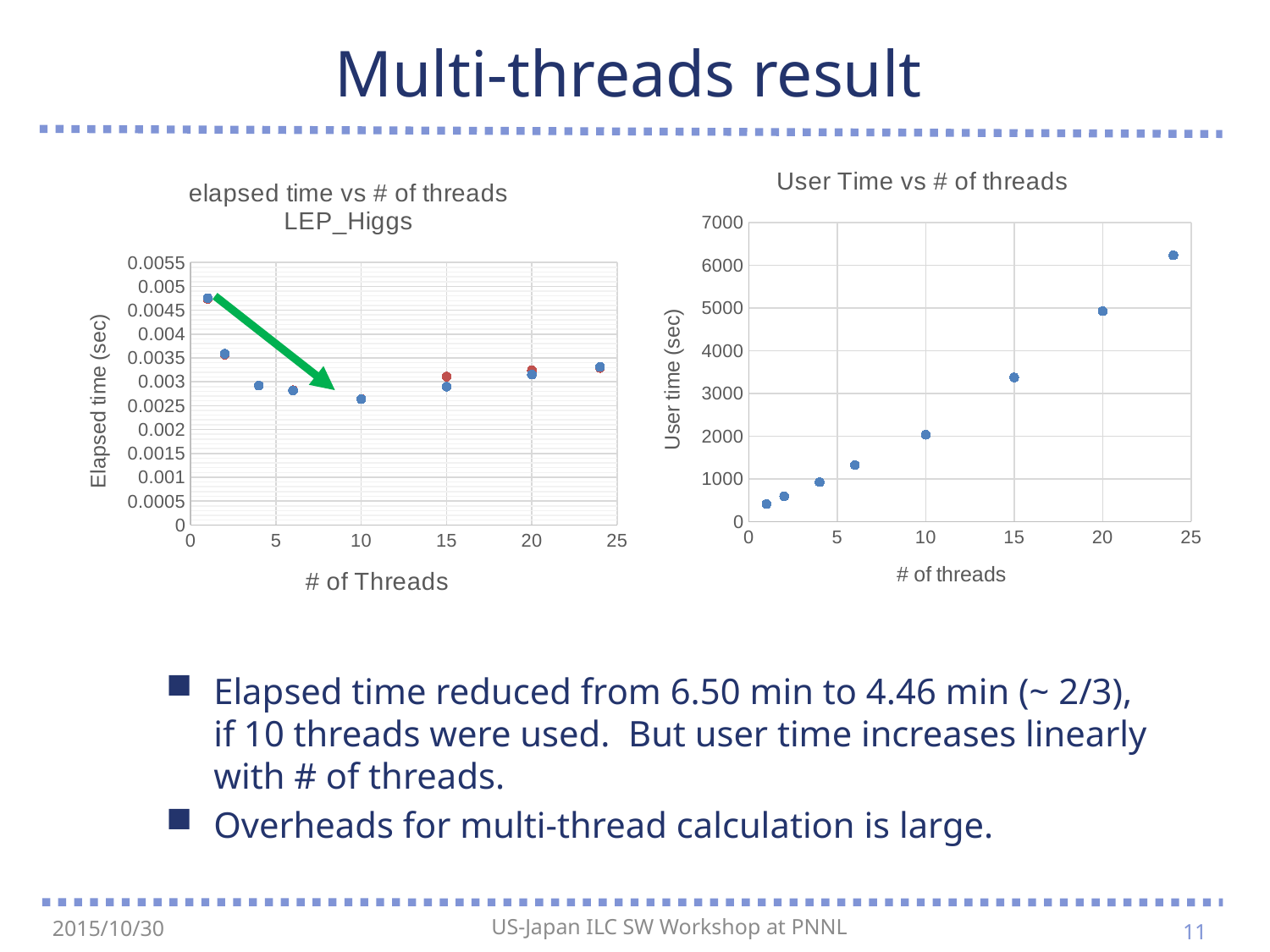
In the 'elapsed time vs # of threads LEP_Higgs' chart, at how many threads is the elapsed time lowest? 10 In the 'elapsed time vs # of threads LEP_Higgs' chart, is the elapsed time at 10 threads greater or less than 0.003? less In the 'User Time vs # of threads' chart, is the user time at 24 threads greater or less than 6000? greater In the 'User Time vs # of threads' chart, at how many threads is the user time highest? 24 In the 'elapsed time vs # of threads LEP_Higgs' chart, is the elapsed time at 1 thread greater or less than 0.0045? greater How many data points are plotted in the 'User Time vs # of threads' chart? 8 What is the y-axis label of the 'elapsed time vs # of threads LEP_Higgs' chart? Elapsed time (sec) In the 'elapsed time vs # of threads LEP_Higgs' chart, which has the larger elapsed time: 1 thread or 10 threads? 1 thread In the 'User Time vs # of threads' chart, do the values rise or fall as the number of threads increases? rise What kind of chart is the 'User Time vs # of threads' chart? scatter chart